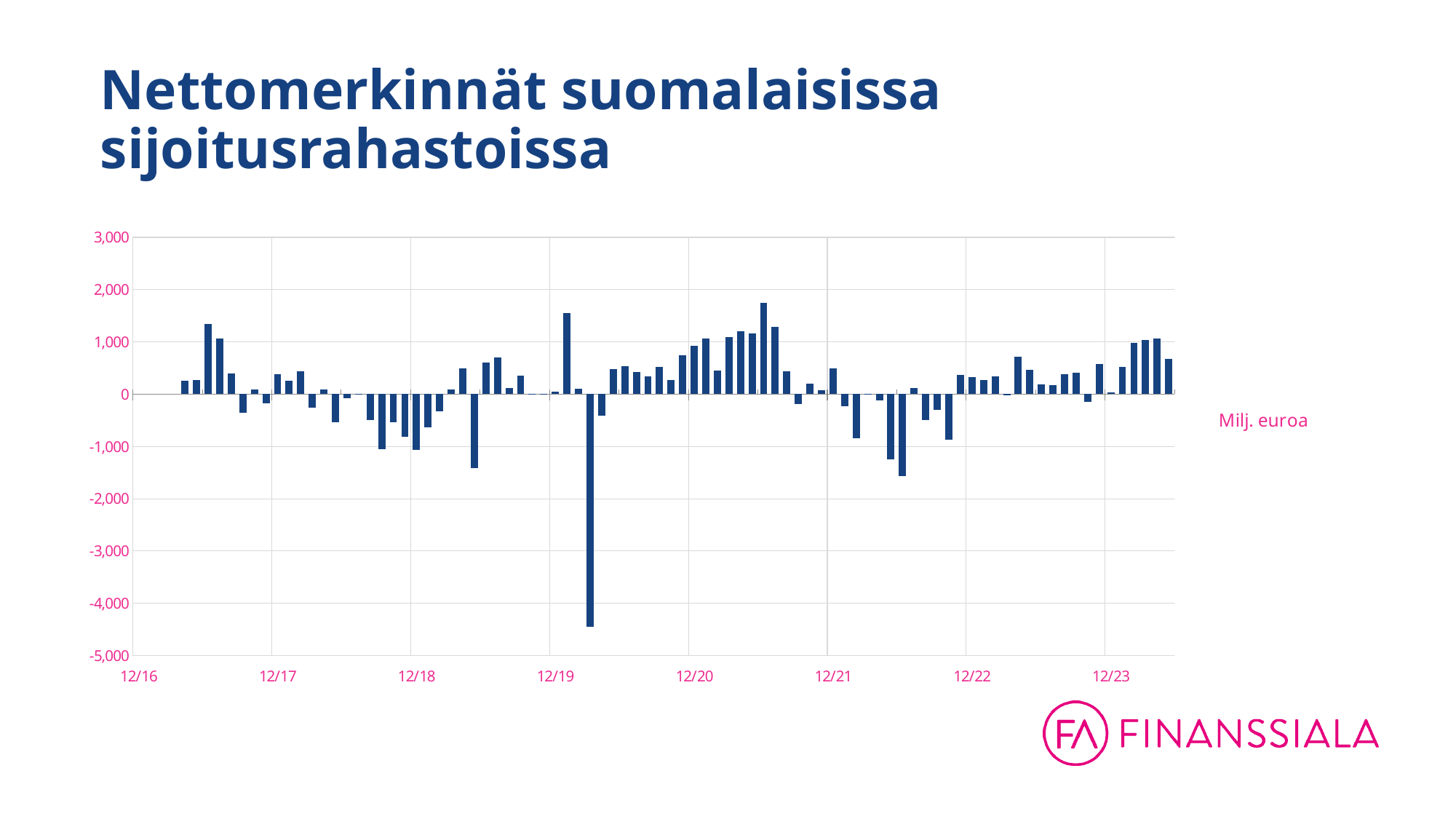
Is the lowest bar on the chart greater or less than -4,000? less Between which two x-axis labels does the lowest bar on the chart fall? 12/19 and 12/20 What is the lowest value shown on the y axis? -5,000 What unit label is shown next to the chart? Milj. euroa What is the first label on the x axis? 12/16 Is the lowest bar between 12/21 and 12/22 greater or less than -1,000? less Is the highest bar on the chart greater or less than 1,000? greater What kind of chart is shown on the slide? bar chart How many labels are shown on the x axis? 8